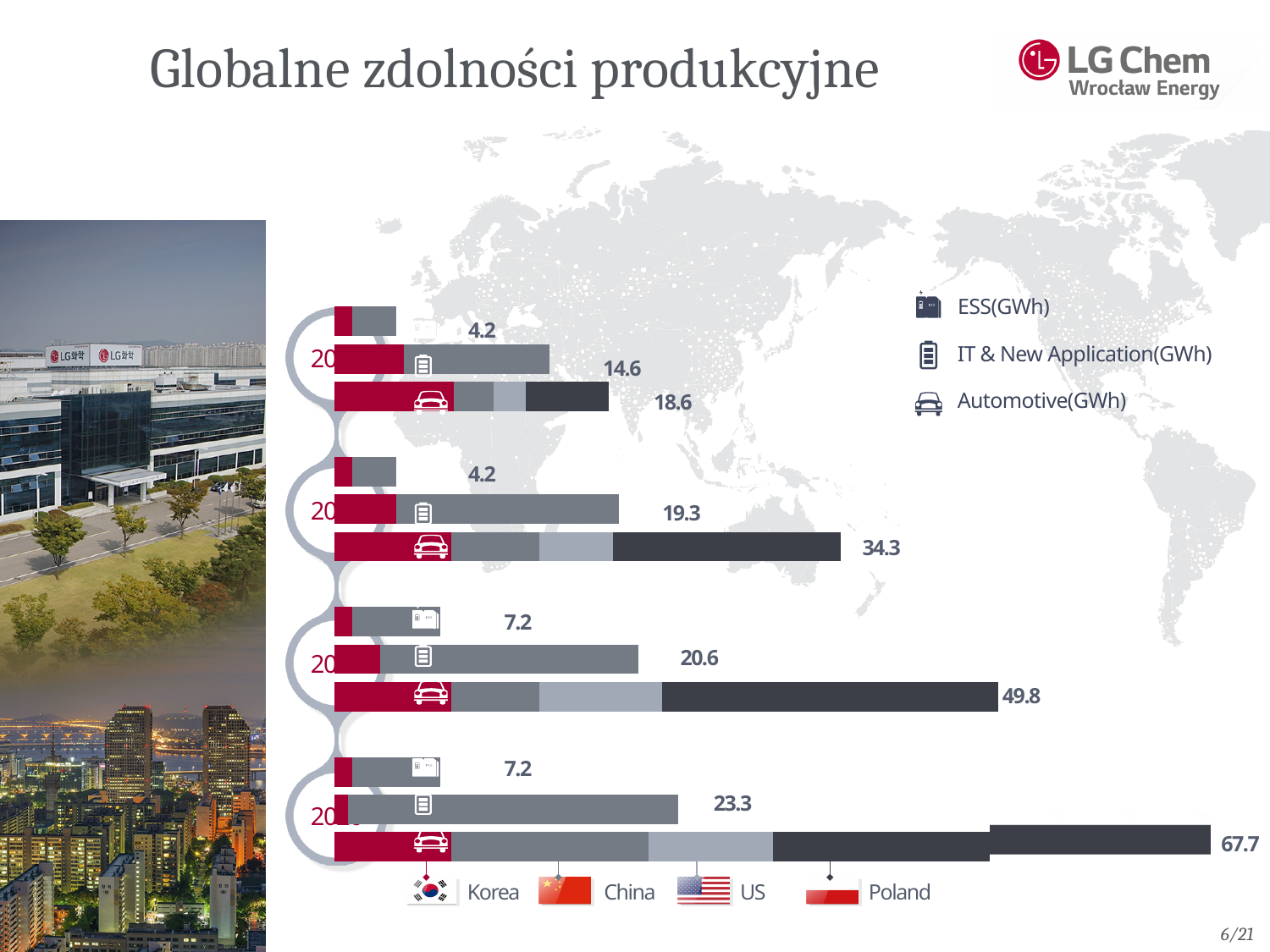
What is the IT & New Application(GWh) value in the topmost group of bars? 14.6 How many countries are listed in the legend at the bottom of the chart? 4 What is the difference between the Automotive(GWh) values in the bottom group and the topmost group? 49.1 Do the Automotive(GWh) values rise or fall from the topmost group to the bottom group? Rise Which category has the highest value in the bottom group of bars? Automotive(GWh) What is the Automotive(GWh) value in the bottom group of bars? 67.7 Which category has the lowest value in the topmost group of bars? ESS(GWh) What is the ESS(GWh) value in the second group of bars from the top? 4.2 Which is larger: the IT & New Application(GWh) value in the second group from the top or in the third group from the top? Third group (20.6) What is the Automotive(GWh) value in the third group of bars from the top? 49.8 What is the title of the slide? Globalne zdolności produkcyjne What type of chart is shown on the slide? Bar chart